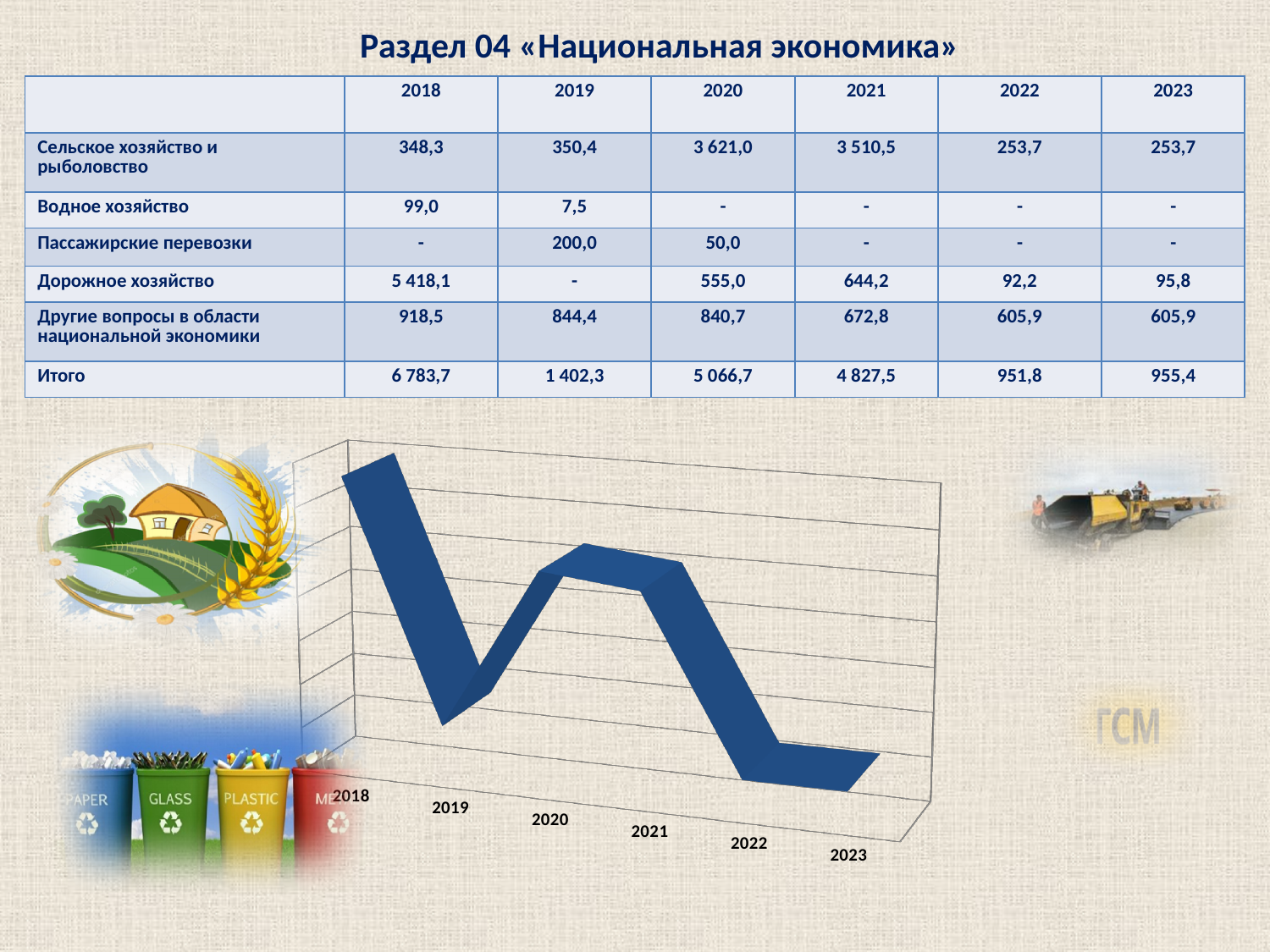
Does the line chart rise or fall from 2019 to 2020? rise Does the line chart rise or fall from 2018 to 2019? fall In the line chart, is the value for 2018 larger or smaller than the value for 2020? larger How many years are plotted along the x axis of the line chart? 6 What is the first year label on the x axis of the line chart? 2018 What colour is the line in the line chart? blue Is the last value (2023) in the line chart higher or lower than the first value (2018)? lower In the line chart, which is larger, the value for 2019 or the value for 2020? 2020 Which year has the highest value in the line chart? 2018 In the line chart, which is larger, the value for 2021 or the value for 2022? 2021 What kind of chart is shown at the bottom of the slide? line chart